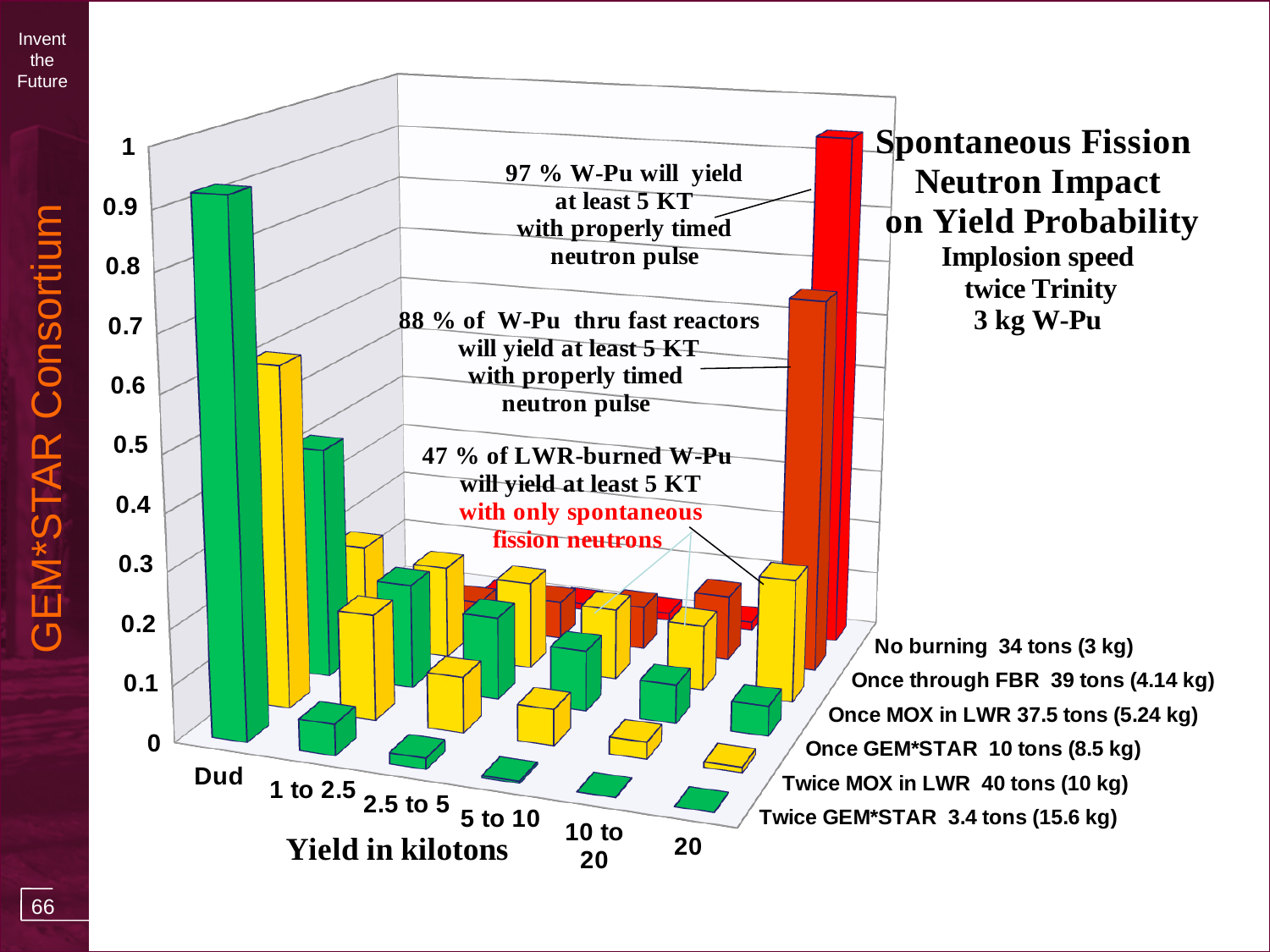
For the 'Twice GEM*STAR 3.4 tons (15.6 kg)' series, which yield category has the tallest bar? Dud How many yield categories are shown along the x axis of the chart? 6 For the 'No burning 34 tons (3 kg)' series, which yield category has the tallest bar? 20 What is the title of the chart? Spontaneous Fission Neutron Impact on Yield Probability Is the value for 'Twice GEM*STAR 3.4 tons (15.6 kg)' at yield 20 greater or less than 0.1? less What is the label of the x axis of the chart? Yield in kilotons Is the value for 'Twice GEM*STAR 3.4 tons (15.6 kg)' at Dud greater or less than 0.5? greater For the 'Twice GEM*STAR 3.4 tons (15.6 kg)' series, which is larger: the bar at Dud or the bar at 20? Dud Is the value for 'No burning 34 tons (3 kg)' at yield 20 greater or less than 0.5? greater What kind of chart is shown on the slide? bar chart For the 'No burning 34 tons (3 kg)' series, which is larger: the bar at Dud or the bar at 20? 20 How many series (fuel burning cases) are plotted in the chart? 6